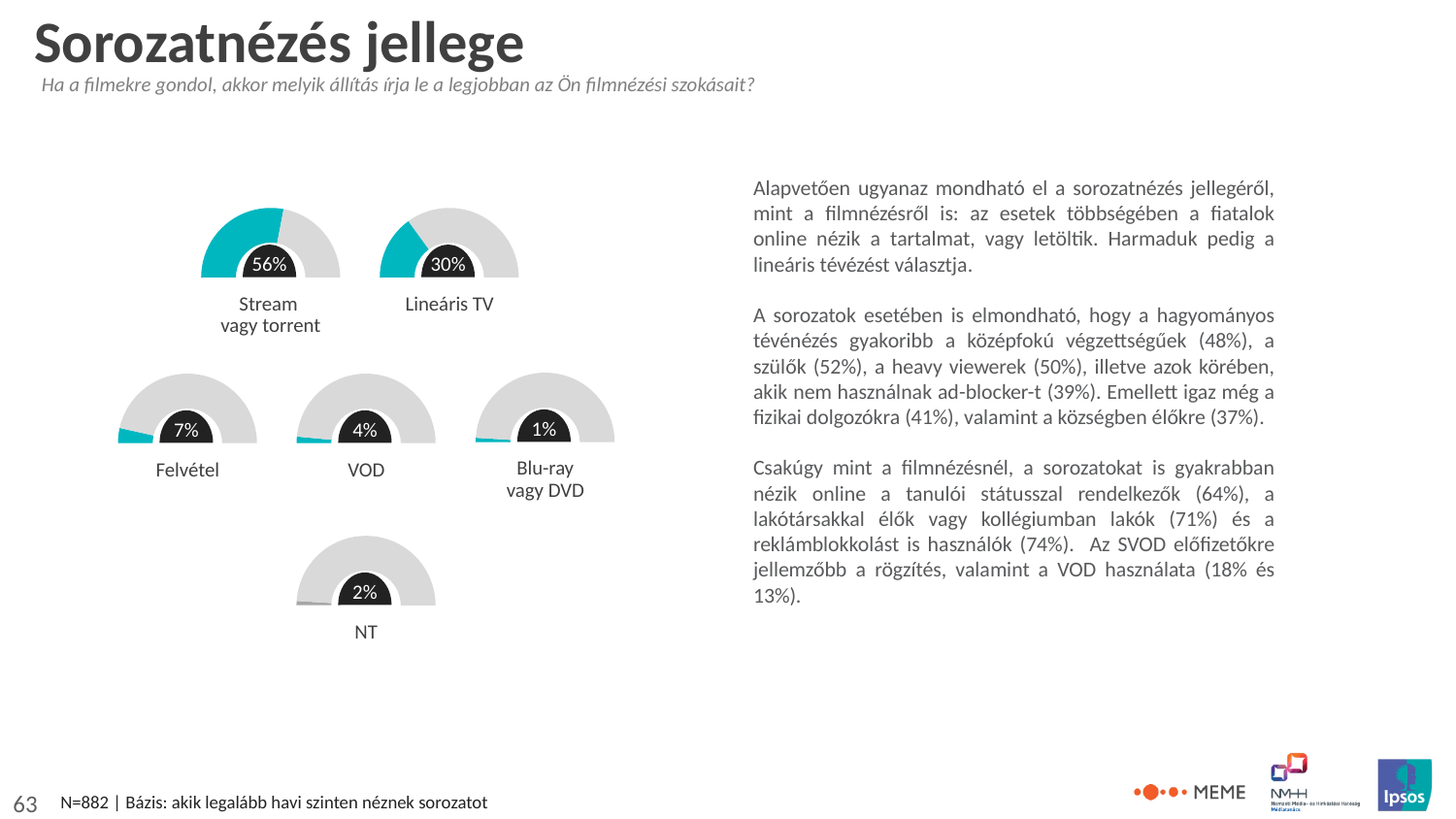
How many gauge charts (categories) are shown on the slide? 6 What percentage is shown for "Blu-ray vagy DVD"? 1% What percentage is shown for "NT"? 2% Which category has the highest percentage among the gauge charts? Stream vagy torrent What percentage is shown for "Lineáris TV"? 30% What percentage is shown for "VOD"? 4% What is the difference in percentage points between "Stream vagy torrent" and "Lineáris TV"? 26 Which is larger, the value for "Felvétel" or the value for "VOD"? Felvétel What is the sample size (N) stated at the bottom of the slide? N=882 What percentage is shown for "Felvétel"? 7% What percentage is shown for "Stream vagy torrent"? 56% Which category has the lowest percentage among the gauge charts? Blu-ray vagy DVD